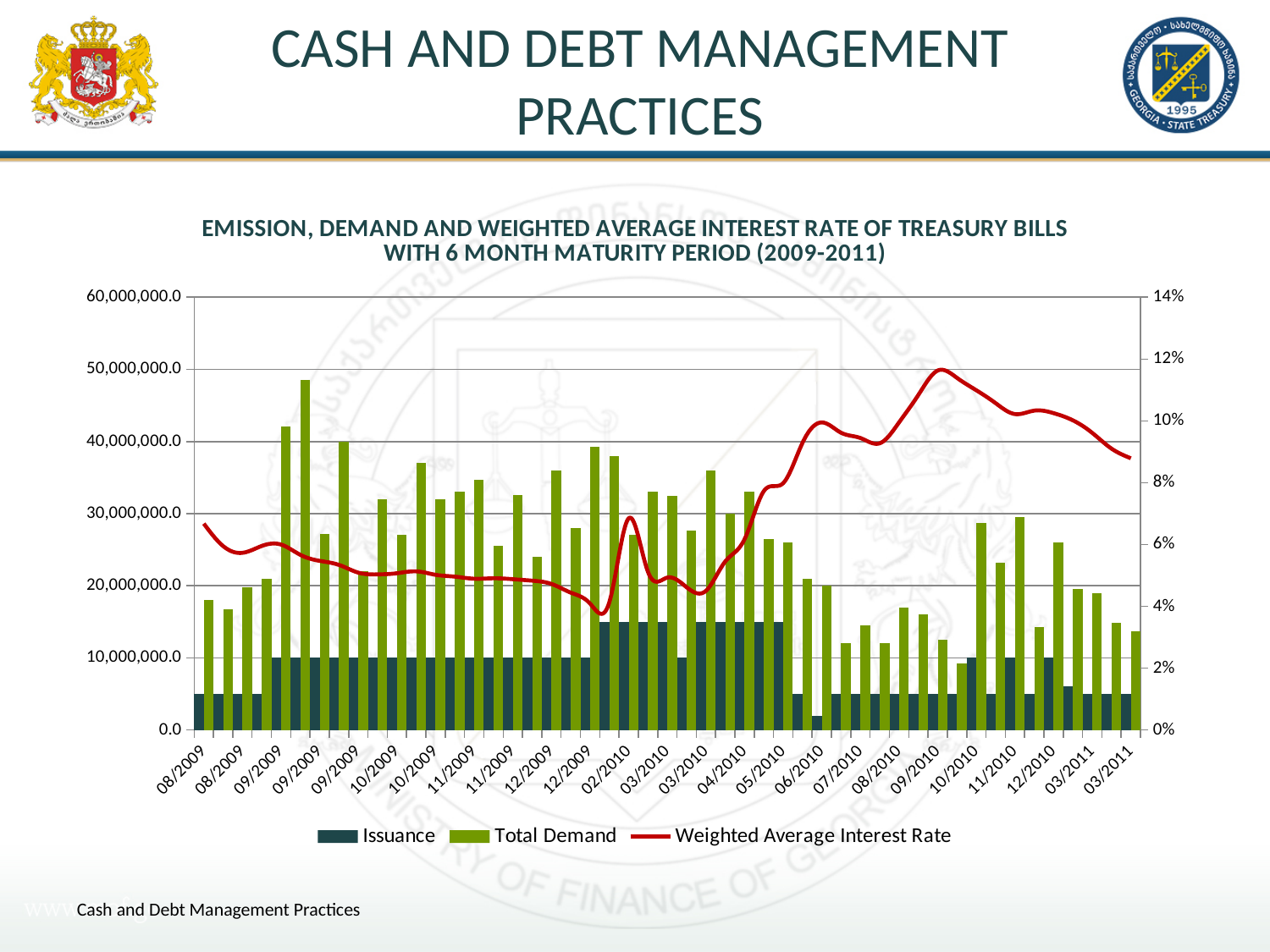
How many series does the legend list? 3 What kind of chart is shown on the slide? Combination bar and line chart Which period has the highest Total Demand? 09/2009 (second bar) What is the title of the chart? EMISSION, DEMAND AND WEIGHTED AVERAGE INTEREST RATE OF TREASURY BILLS WITH 6 MONTH MATURITY PERIOD (2009-2011) Is the Total Demand value for the first 08/2009 bar greater or less than 20,000,000.0? less Which series is plotted as a red line? Weighted Average Interest Rate Does the Weighted Average Interest Rate rise or fall between 05/2010 and 09/2010? rise Is the Weighted Average Interest Rate at the second 03/2010 point greater or less than 6%? less Which is larger, the Total Demand for the second 09/2009 bar or for the first 08/2009 bar? 09/2009 (second bar) Does the Weighted Average Interest Rate rise or fall between 09/2010 and the last 03/2011 point? fall Is the Weighted Average Interest Rate at 09/2010 greater or less than 10%? greater